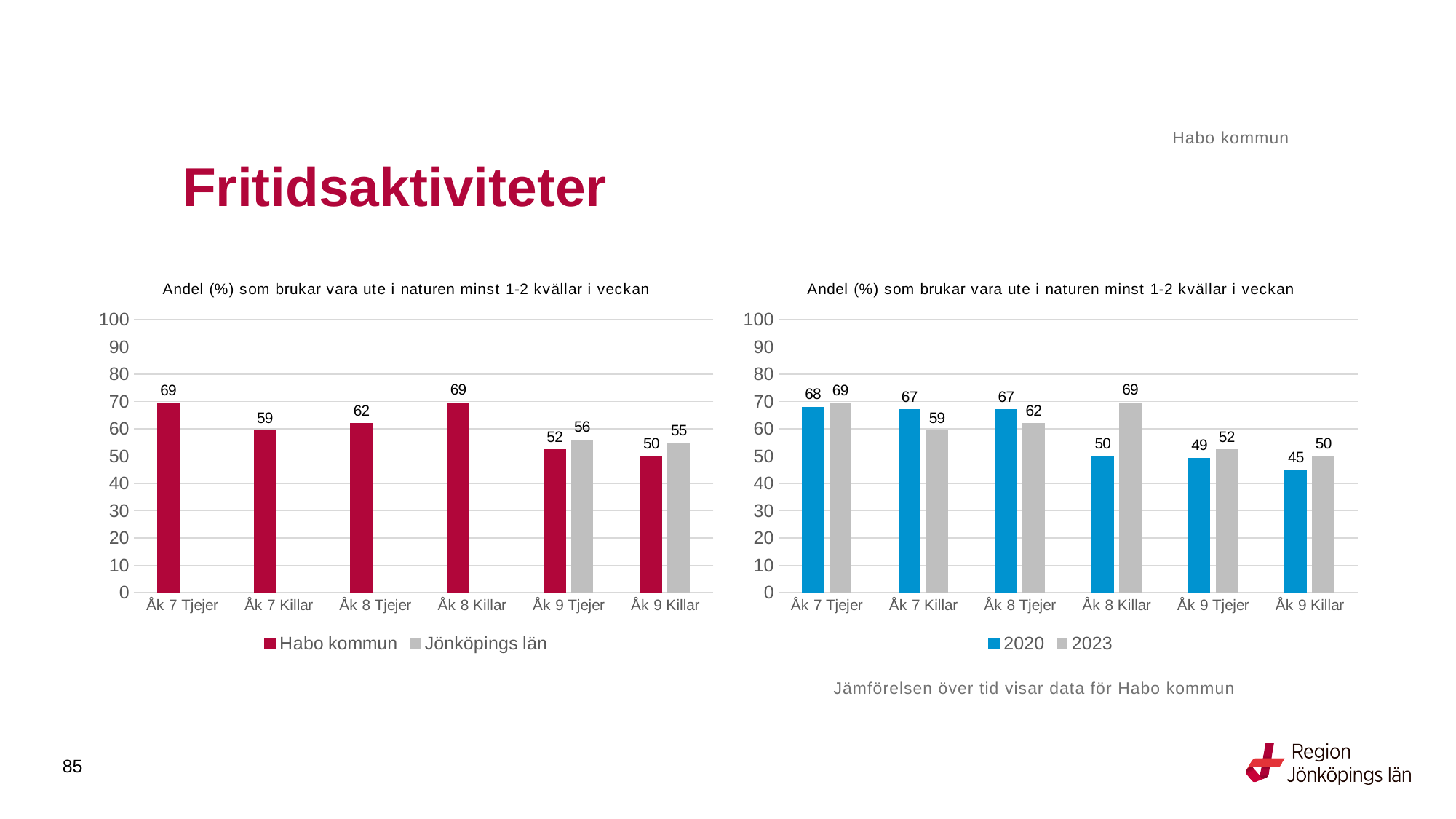
How many categories are shown on the x axis of the right chart? 6 In the left chart, how many series does the legend list? 2 In the right chart, which is larger for Åk 7 Killar, the 2020 value or the 2023 value? 2020 In the left chart, what is the difference between the Jönköpings län and Habo kommun values for Åk 9 Killar? 5 In the right chart, what is the difference between the 2023 and 2020 values for Åk 8 Killar? 19 In the right chart, what is the 2023 value for Åk 8 Tjejer? 62 In the left chart, what is the value for Habo kommun for Åk 7 Killar? 59 In the left chart, which category has the lowest Habo kommun value? Åk 9 Killar What type of chart is the right chart? Bar chart In the right chart, which category has the lowest 2020 value? Åk 9 Killar In the right chart, what is the 2020 value for Åk 8 Killar? 50 In the left chart, what is the value for Jönköpings län for Åk 9 Tjejer? 56